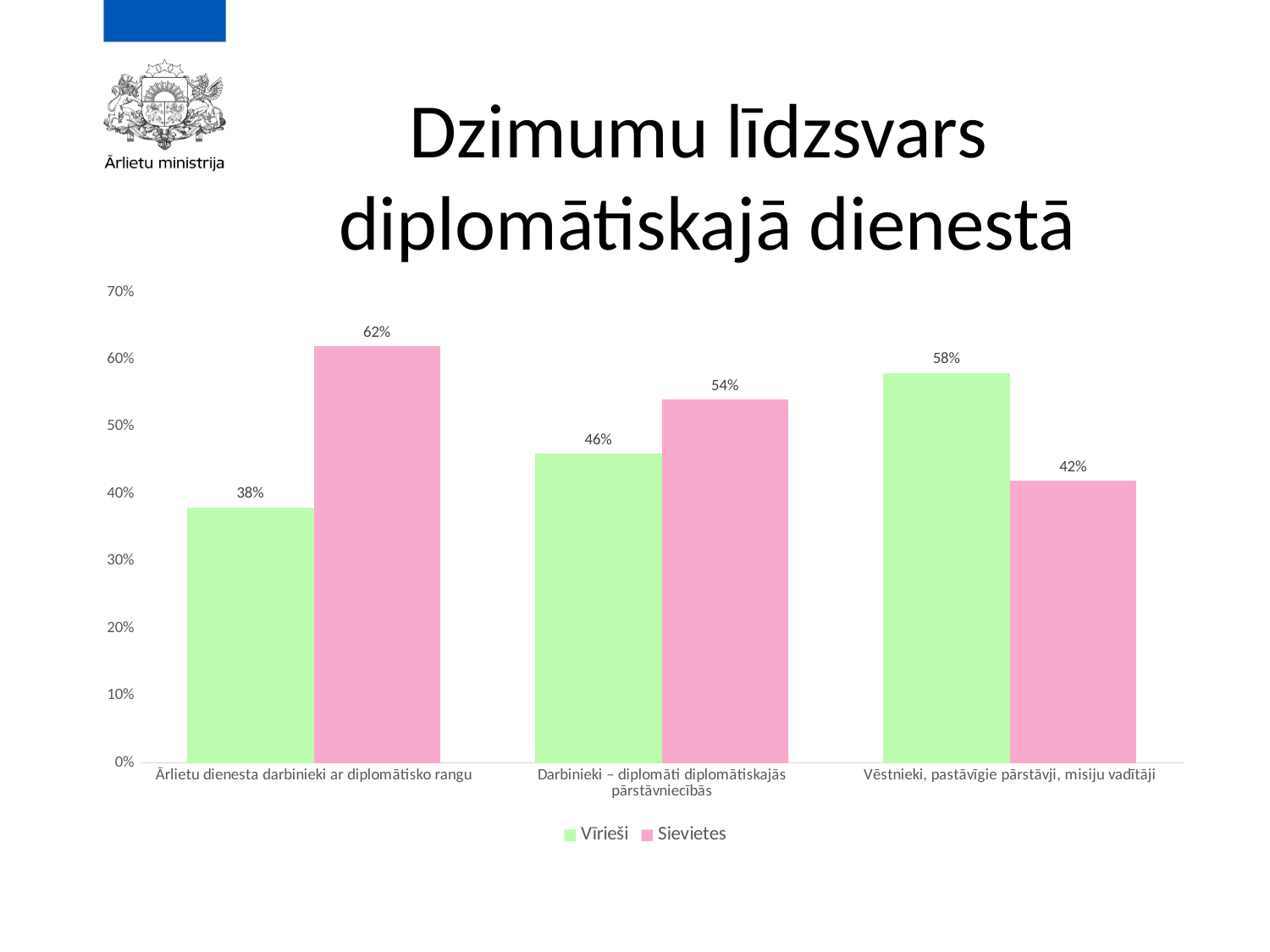
Which is larger in the category 'Darbinieki – diplomāti diplomātiskajās pārstāvniecībās': Vīrieši or Sievietes? Sievietes What is the title of the slide? Dzimumu līdzsvars diplomātiskajā dienestā What kind of chart is shown on the slide? Bar chart What is the value for Sievietes in the category 'Vēstnieki, pastāvīgie pārstāvji, misiju vadītāji'? 42% In which category is the Vīrieši value highest? Vēstnieki, pastāvīgie pārstāvji, misiju vadītāji How many categories are shown on the x axis? 3 What is the value for Sievietes in the category 'Ārlietu dienesta darbinieki ar diplomātisko rangu'? 62% What is the value for Vīrieši in the category 'Ārlietu dienesta darbinieki ar diplomātisko rangu'? 38% How many series does the legend list? 2 In which category is the Sievietes value lowest? Vēstnieki, pastāvīgie pārstāvji, misiju vadītāji What is the difference between the Sievietes and Vīrieši values in the category 'Ārlietu dienesta darbinieki ar diplomātisko rangu'? 24% What is the value for Vīrieši in the category 'Darbinieki – diplomāti diplomātiskajās pārstāvniecībās'? 46%